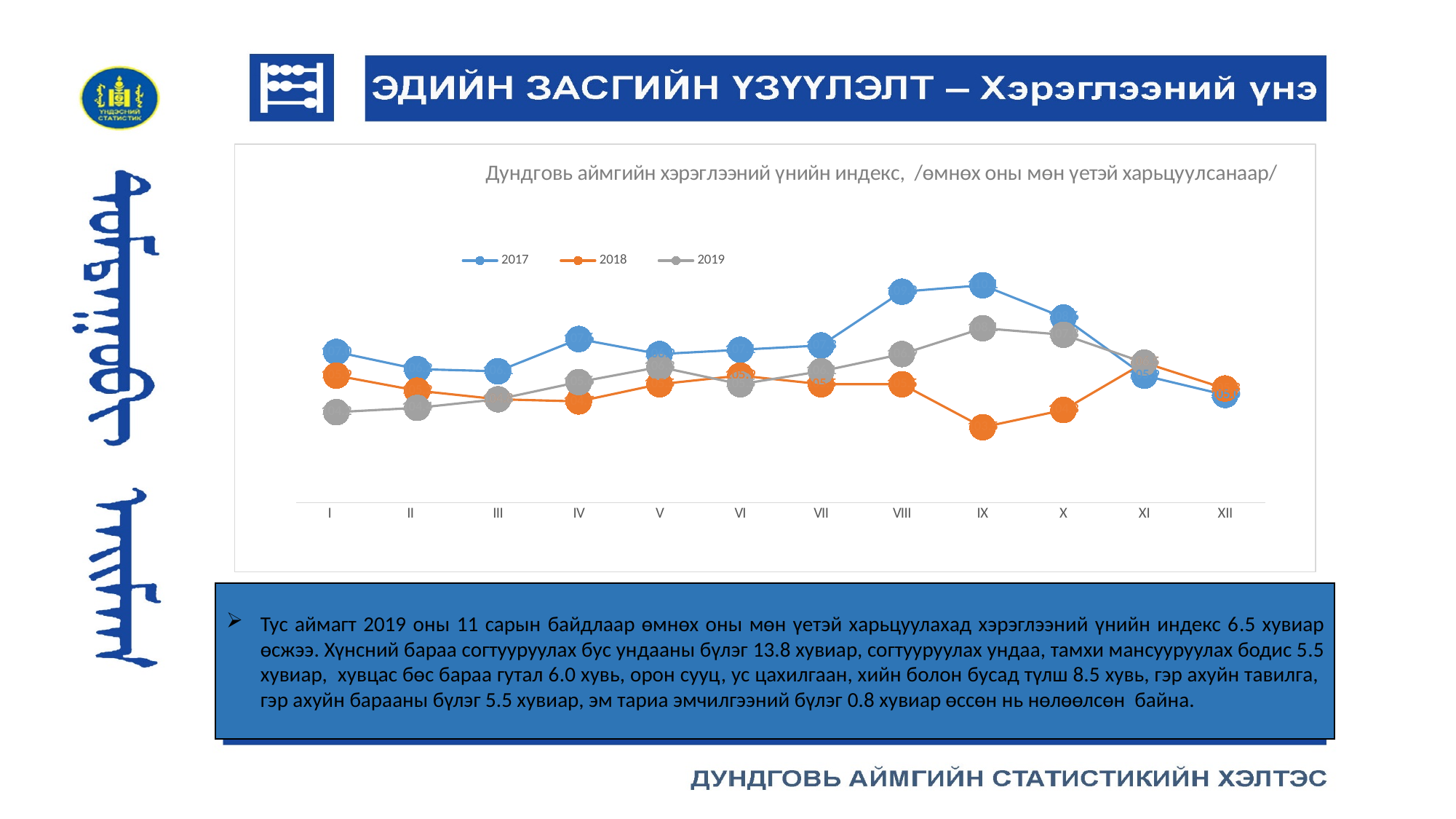
In which month does the 2017 series reach its highest value? IX Does the 2017 series rise or fall from month VII to month IX? rise In which month does the 2018 series reach its lowest value? IX Does the 2018 series rise or fall from month VIII to month IX? fall What kind of chart is shown on the slide? line chart How many points (months) are plotted along the x axis for each series? 12 for 2017 and 2018; 11 for 2019 (no XII point) In month X, which series has the higher value, 2018 or 2019? 2019 Which colour is used for the 2018 series? orange Which series are listed in the chart legend? 2017, 2018, 2019 In month IX, which series has the higher value, 2017 or 2018? 2017 How many series does the chart legend list? 3 In which month does the 2017 series reach its lowest value? XII